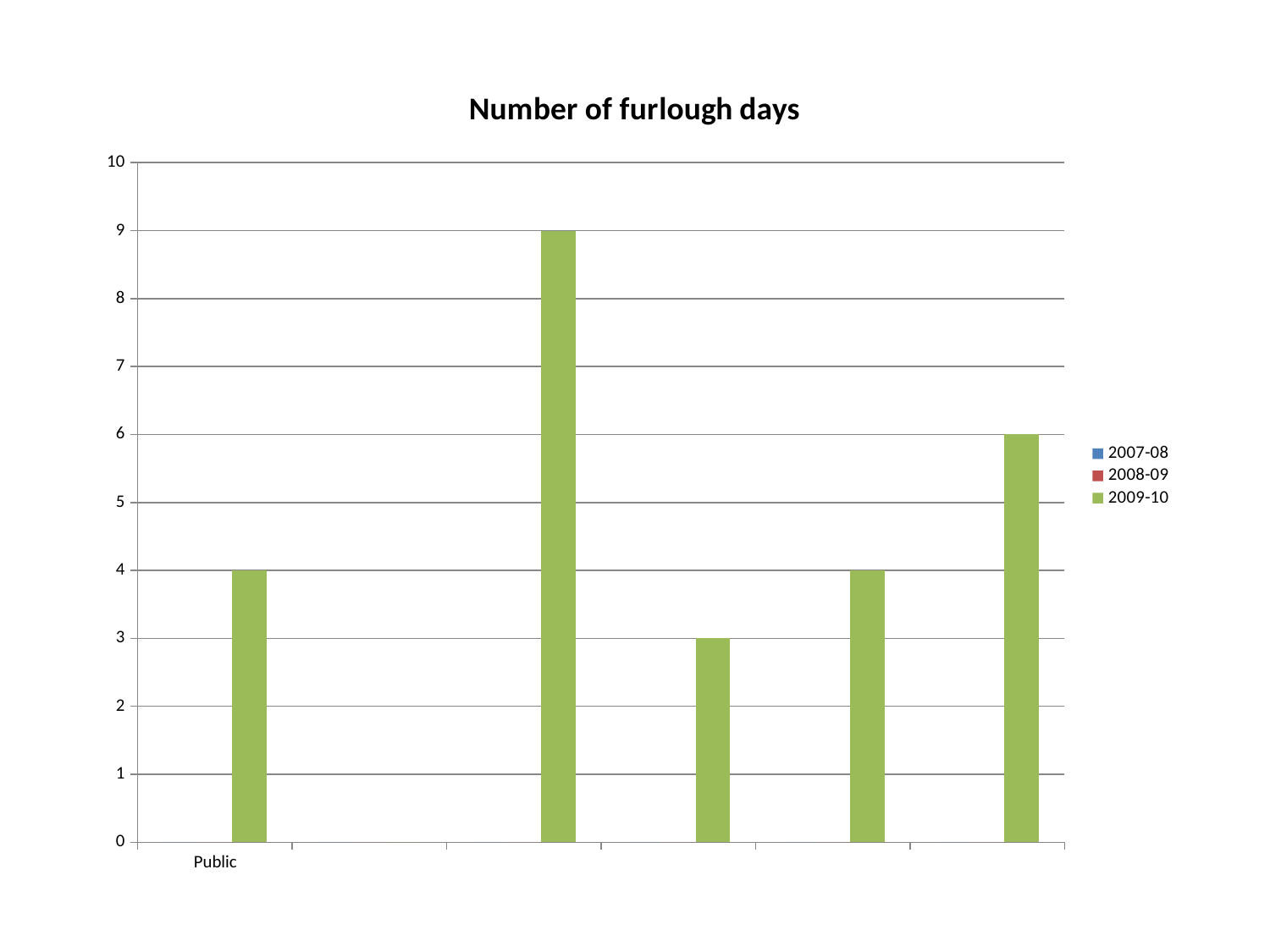
How many bars are plotted on the chart? 5 What is the value of the tallest bar on the chart? 9 What is the value of the shortest bar on the chart? 3 Is the value for Public greater or less than 5? less Which series in the legend is shown in green? 2009-10 How many series does the legend list? 3 What is the number of furlough days for Public? 4 What kind of chart is shown on the slide? bar chart What is the highest value shown on the vertical axis? 10 Is the tallest bar greater or less than 8? greater What is the title of the chart? Number of furlough days